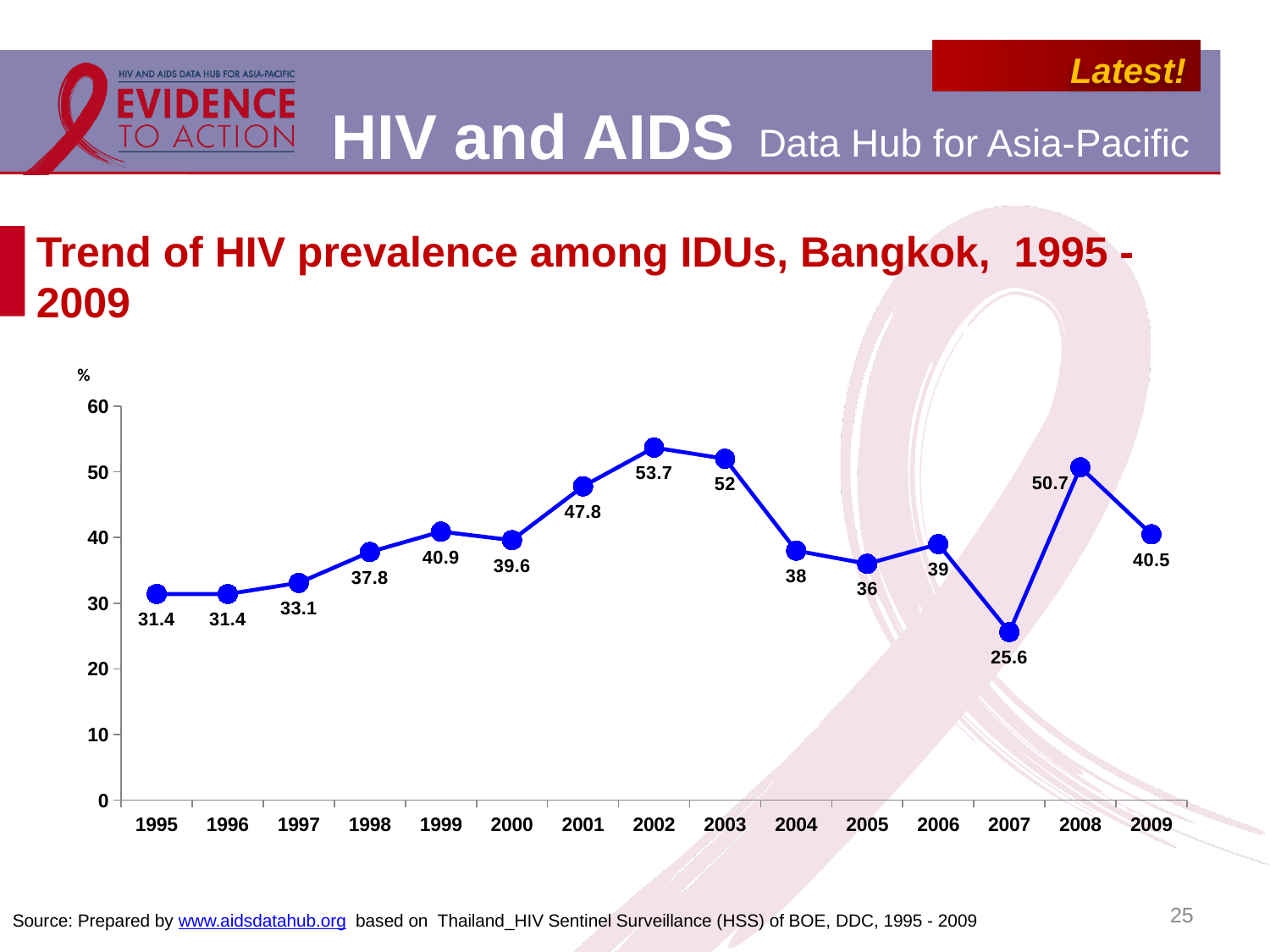
What kind of chart is shown on the slide? line chart What is the HIV prevalence among IDUs in Bangkok in 2002? 53.7 Is the HIV prevalence in 2003 greater or less than 50? greater Which year has the lowest HIV prevalence among IDUs in Bangkok? 2007 Which year has the highest HIV prevalence among IDUs in Bangkok? 2002 What is the HIV prevalence among IDUs in Bangkok in 2007? 25.6 Which year has a higher HIV prevalence, 2001 or 2006? 2001 What unit is shown on the y axis of the chart? % What is the HIV prevalence among IDUs in Bangkok in 2009? 40.5 How many years are plotted on the chart? 15 What is the difference in HIV prevalence between 2008 and 2007? 25.1 Did HIV prevalence among IDUs rise or fall from 1995 to 2002? rise